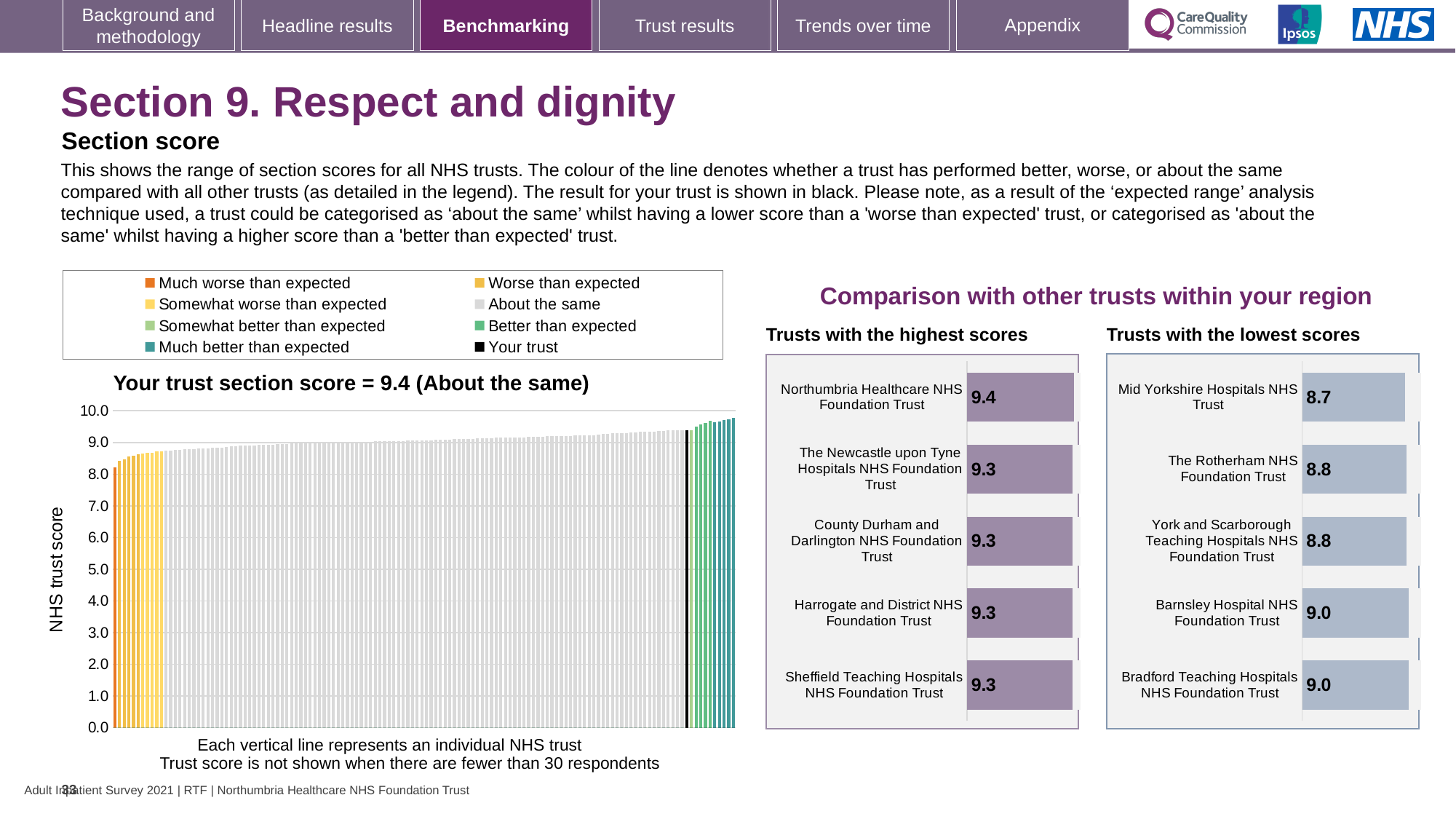
In the 'Your trust section score' chart, do the bars rise or fall from left to right? Rise How many entries does the legend above the 'Your trust section score' chart list? 8 In the 'Your trust section score' chart, is the value of the leftmost bar greater or less than 9.0? less In the 'Trusts with the highest scores' chart, what is the score for Northumbria Healthcare NHS Foundation Trust? 9.4 In the 'Trusts with the highest scores' chart, what is the score for Sheffield Teaching Hospitals NHS Foundation Trust? 9.3 In the 'Trusts with the lowest scores' chart, which trust has the lowest score? Mid Yorkshire Hospitals NHS Trust How many trusts are listed in the 'Trusts with the lowest scores' chart? 5 In the 'Trusts with the lowest scores' chart, what is the score for Mid Yorkshire Hospitals NHS Trust? 8.7 In the 'Trusts with the lowest scores' chart, which has the larger score: Barnsley Hospital NHS Foundation Trust or The Rotherham NHS Foundation Trust? Barnsley Hospital NHS Foundation Trust What kind of chart is the 'Your trust section score' chart on the left? Bar chart In the 'Trusts with the highest scores' chart, which trust has the highest score? Northumbria Healthcare NHS Foundation Trust In the 'Trusts with the lowest scores' chart, what is the difference between the scores of Bradford Teaching Hospitals NHS Foundation Trust and Mid Yorkshire Hospitals NHS Trust? 0.3